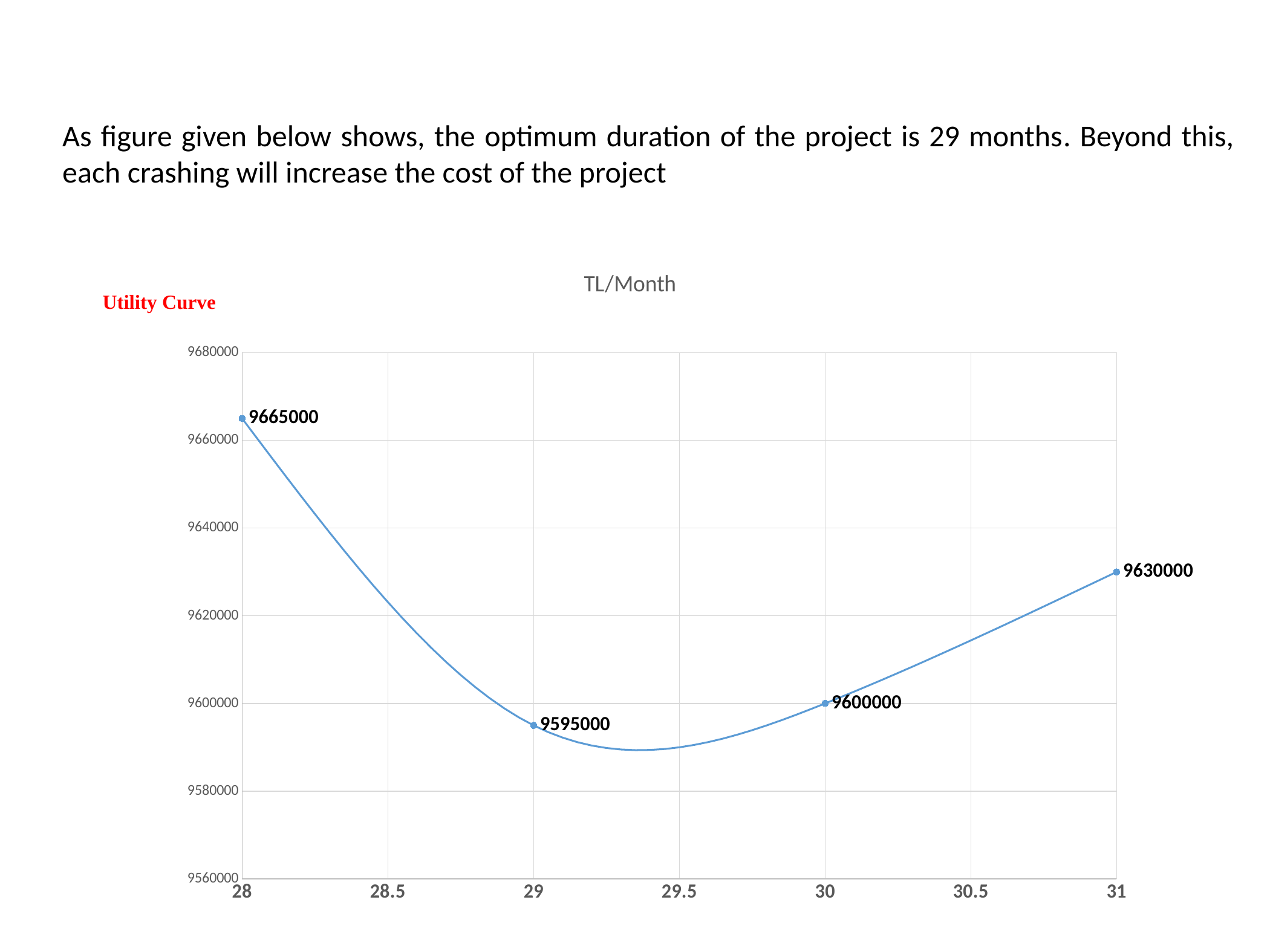
At which duration is the plotted value highest? 28 What is the value plotted at 30 months? 9600000 What is the value plotted at 29 months? 9595000 What kind of chart is shown on the slide? line chart What is the title shown above the chart? TL/Month What is the value plotted at 31 months? 9630000 What is the difference between the values at 28 months and 29 months? 70000 At which duration is the plotted value lowest? 29 How many data points are plotted on the chart? 4 Which is larger, the value at 28 months or the value at 31 months? 28 months What is the difference between the values at 31 months and 30 months? 30000 What is the value plotted at 28 months? 9665000